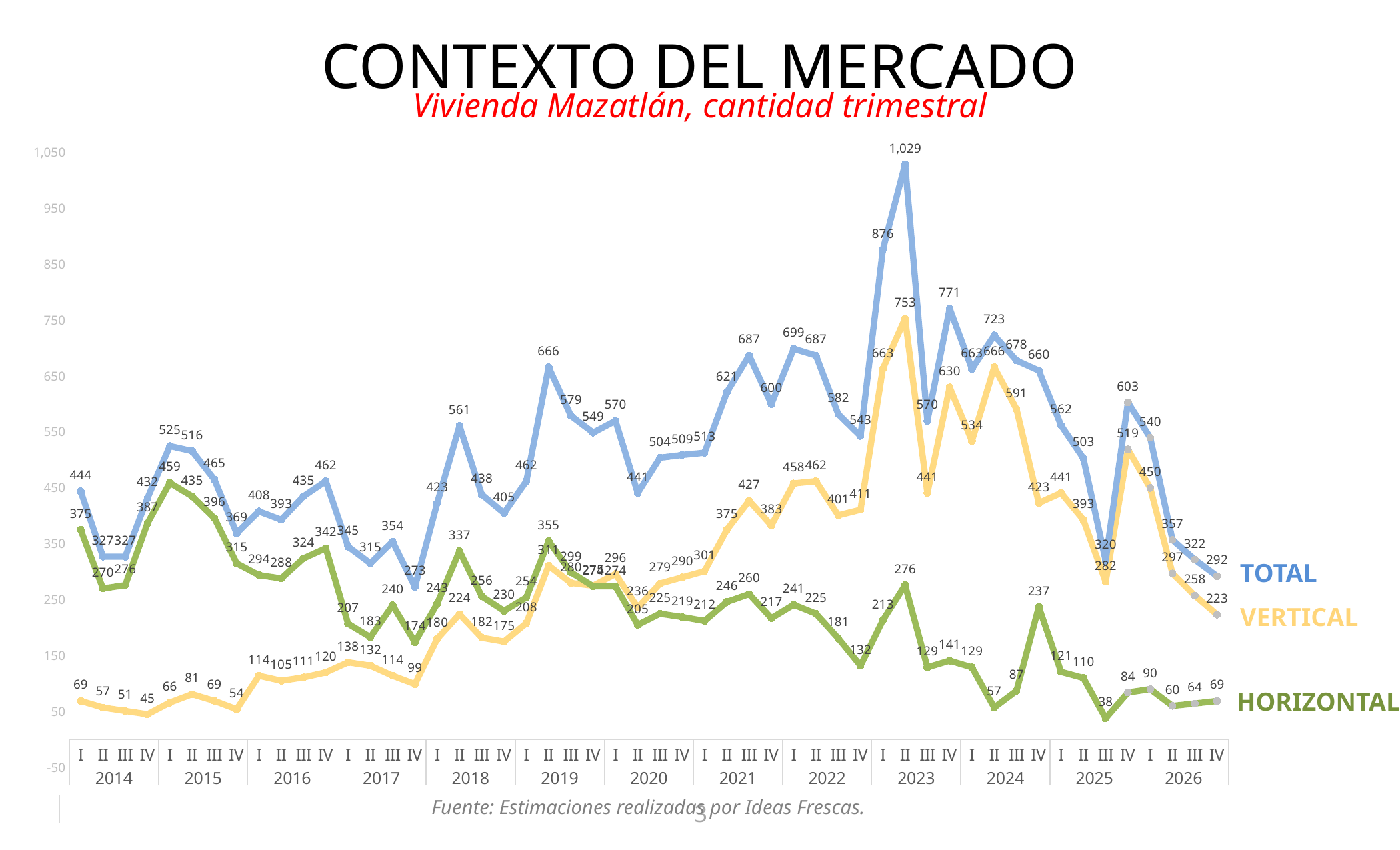
In which quarter does the TOTAL series reach its highest value? 2023 II How many series does the chart show? 3 What is the lowest VERTICAL value on the chart? 45 In quarter I of 2014, which is larger: the VERTICAL value or the HORIZONTAL value? HORIZONTAL What is the difference between the TOTAL and VERTICAL values in quarter II of 2023? 276 How many years are shown along the x axis? 13 What colour is the TOTAL line? blue What kind of chart is shown on the slide? line chart What is the VERTICAL value in quarter II of 2023? 753 What is the HORIZONTAL value in quarter II of 2023? 276 What is the highest TOTAL value on the chart? 1,029 What is the lowest HORIZONTAL value on the chart? 38